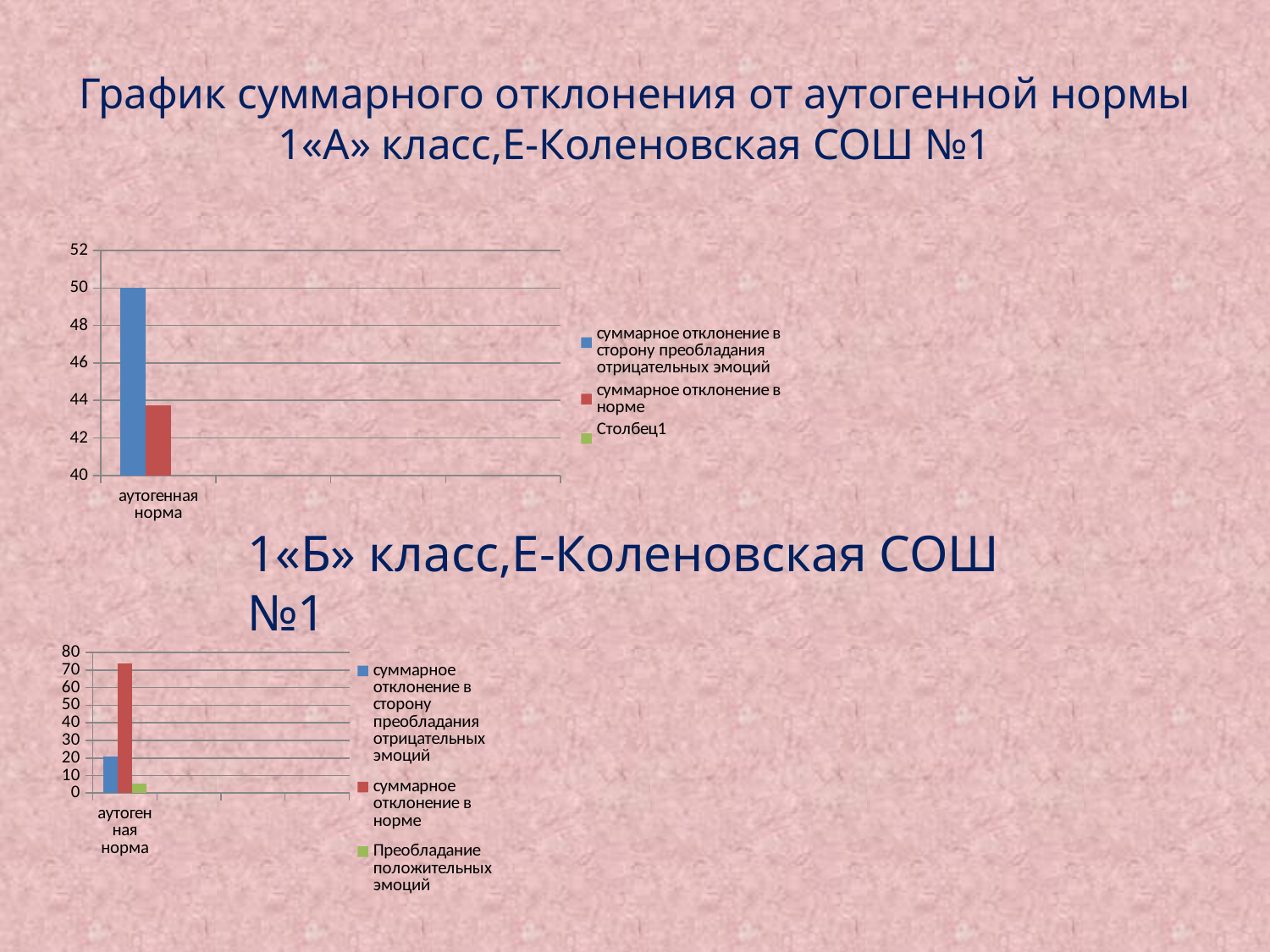
In the bottom chart (1«Б» класс), which series has the highest bar? суммарное отклонение в норме In the top chart (1«А» класс), what is the value of the 'суммарное отклонение в сторону преобладания отрицательных эмоций' bar? 50 In the top chart (1«А» класс), how many series does the legend list? 3 In the bottom chart (1«Б» класс), how many series does the legend list? 3 What kind of chart is the top chart (1«А» класс)? bar chart In the top chart (1«А» класс), is the value for 'суммарное отклонение в норме' greater or less than 44? less In the bottom chart (1«Б» класс), which series has the lowest bar? Преобладание положительных эмоций In the bottom chart (1«Б» класс), is the value for 'суммарное отклонение в норме' greater or less than 70? greater In the bottom chart (1«Б» класс), is the value for 'Преобладание положительных эмоций' greater or less than 10? less In the top chart (1«А» класс), which series has the highest bar? суммарное отклонение в сторону преобладания отрицательных эмоций In the top chart (1«А» класс), which is larger: 'суммарное отклонение в сторону преобладания отрицательных эмоций' or 'суммарное отклонение в норме'? суммарное отклонение в сторону преобладания отрицательных эмоций How many categories are shown on the x axis of the bottom chart (1«Б» класс)? 1